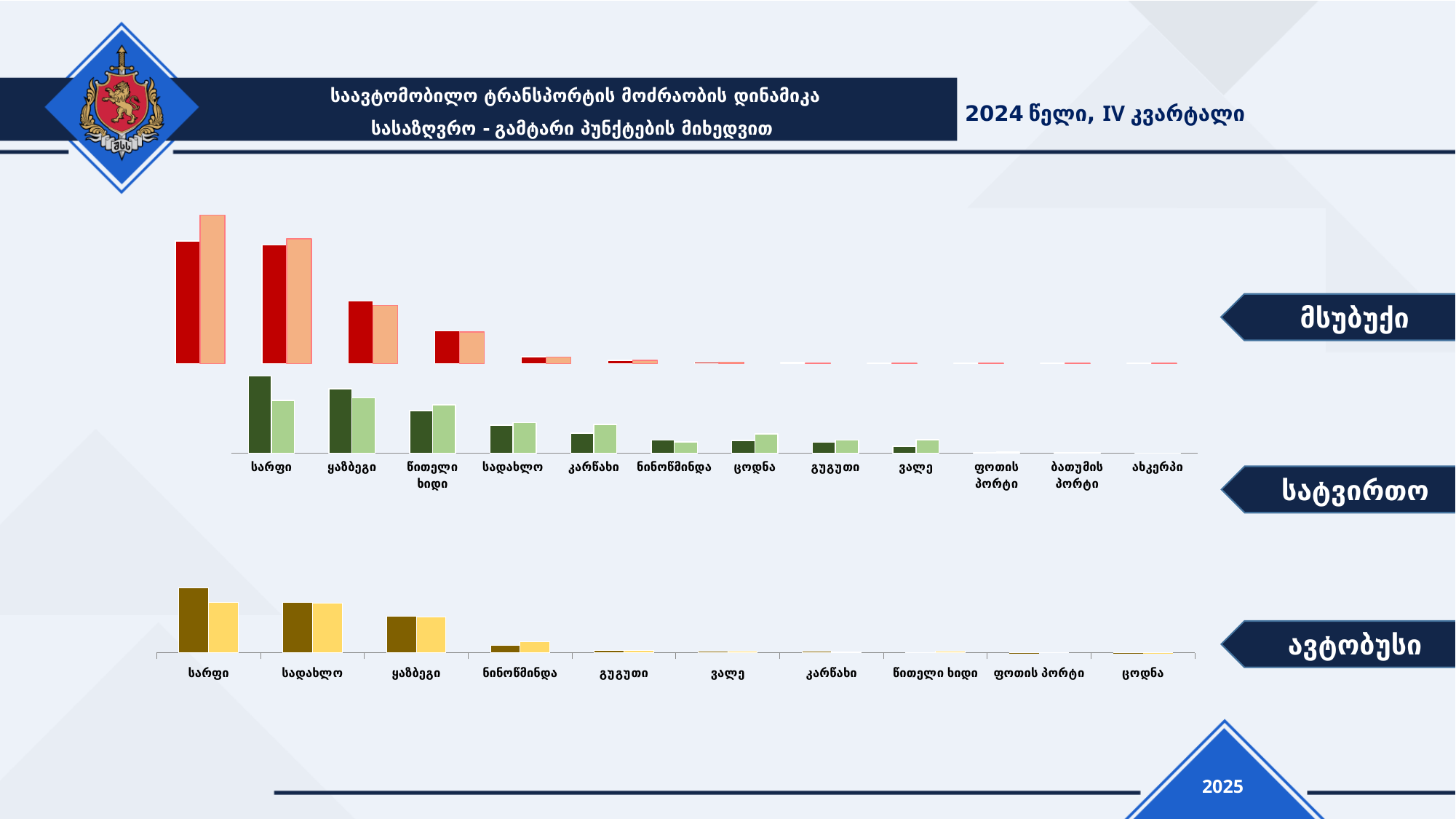
In the 'მსუბუქი' chart, do the values rise or fall from left to right? fall In the 'სატვირთო' chart, which category has the highest dark green bar? სარფი How many categories (pairs of bars) are plotted in the 'მსუბუქი' chart? 12 In the 'სატვირთო' chart, which dark green bar is taller: სარფი or ყაზბეგი? სარფი How many series (bar colours) does the 'მსუბუქი' chart show per category? 2 In the 'სატვირთო' chart, which light green bar is taller: კარწახი or ნინოწმინდა? კარწახი How many categories are labelled on the x axis of the 'ავტობუსი' chart? 10 What kind of chart is the 'მსუბუქი' chart at the top of the slide? bar chart Which period is stated in the header of the slide? 2024 წელი, IV კვარტალი What kind of chart is the 'ავტობუსი' chart at the bottom of the slide? bar chart In the 'ავტობუსი' chart, which category has the highest bars? სარფი How many categories are labelled on the x axis of the 'სატვირთო' chart? 12